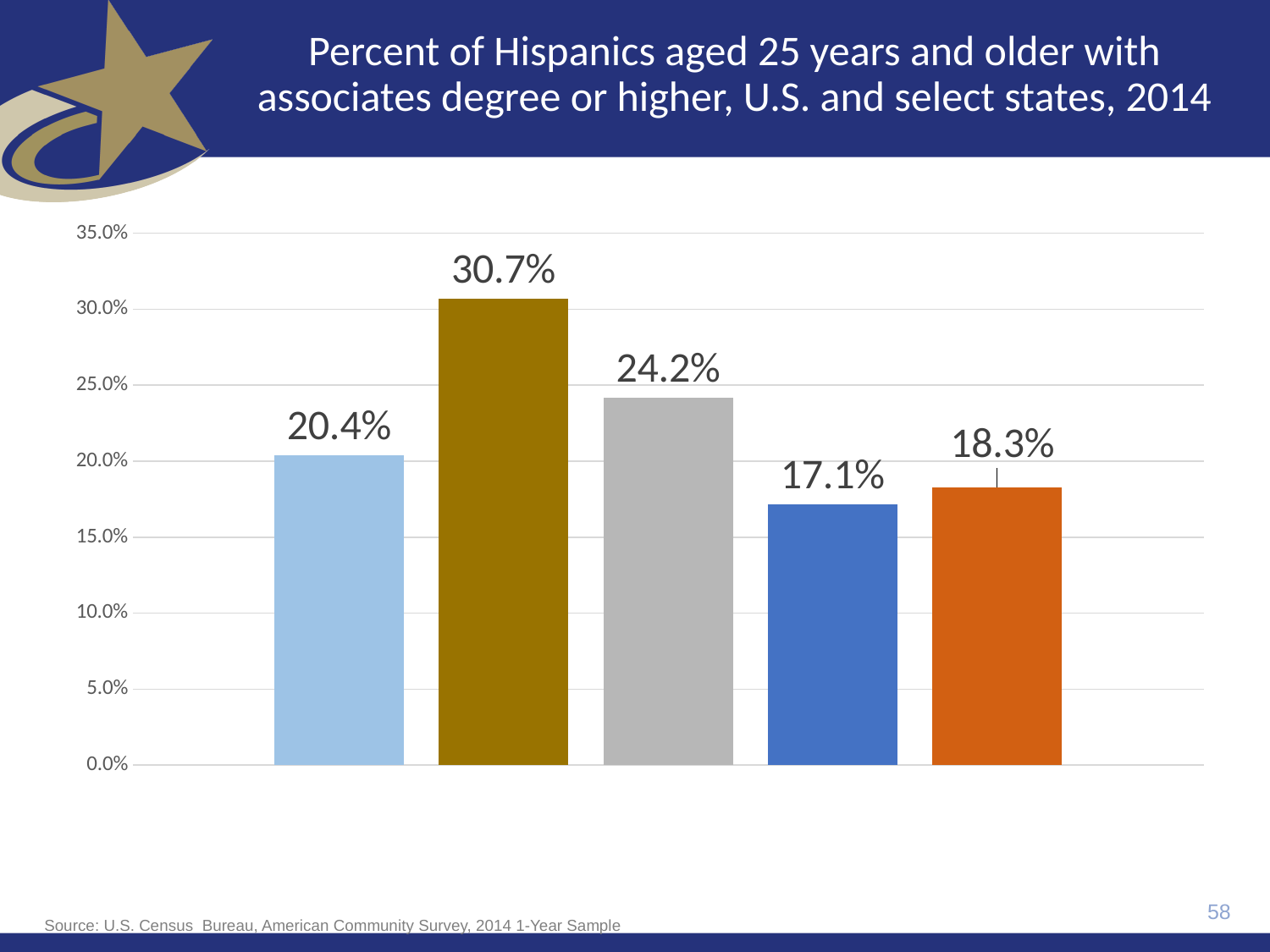
What is the value shown on the fourth (dark blue) bar? 17.1% What is the value shown on the second (gold) bar? 30.7% What is the value shown on the first (leftmost, light blue) bar? 20.4% How many bars are plotted in the chart? 5 What is the value shown on the fifth (rightmost, orange) bar? 18.3% What is the title of the chart on the slide? Percent of Hispanics aged 25 years and older with associates degree or higher, U.S. and select states, 2014 Which is larger, the value of the third (gray) bar or the value of the first (light blue) bar? the third (gray) bar, 24.2% What is the value shown on the third (gray) bar? 24.2% Which bar has the highest value? the second (gold) bar, 30.7% What is the difference between the highest bar (30.7%) and the lowest bar (17.1%)? 13.6% Which bar has the lowest value? the fourth (dark blue) bar, 17.1% What kind of chart is shown on the slide? bar chart